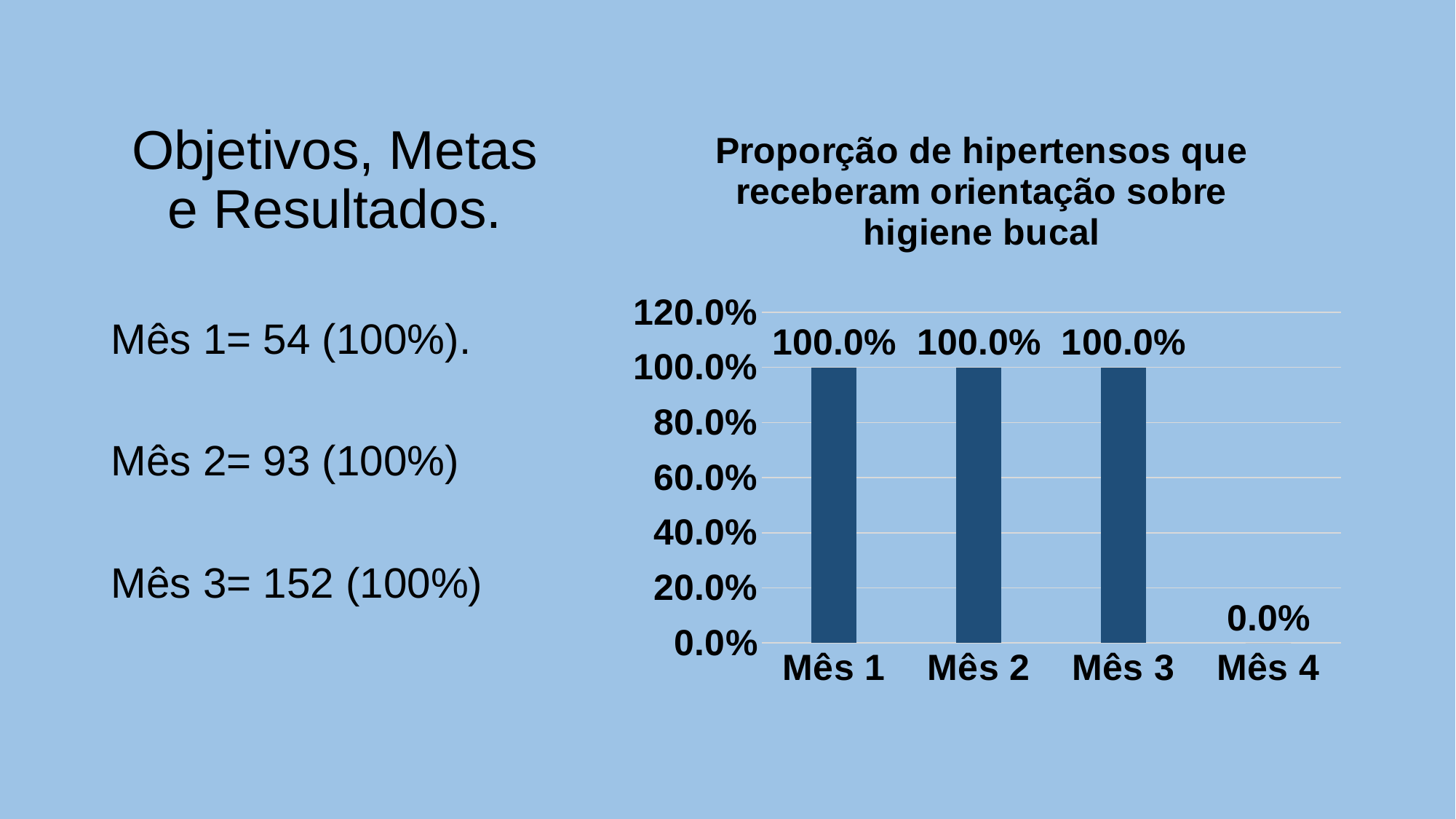
How many categories are shown on the x axis? 4 What is the value for Mês 3? 100.0% What is the difference between the values for Mês 2 and Mês 4? 100.0% How many categories have a value of 100.0%? 3 What is the value for Mês 1? 100.0% What is the title of the chart? Proporção de hipertensos que receberam orientação sobre higiene bucal What kind of chart is shown on the slide? bar chart What is the highest value shown on the y axis? 120.0% Which is larger, the value for Mês 3 or the value for Mês 4? Mês 3 What is the value for Mês 4? 0.0% Is the value for Mês 2 greater or less than 80.0%? greater Which category has the lowest value? Mês 4